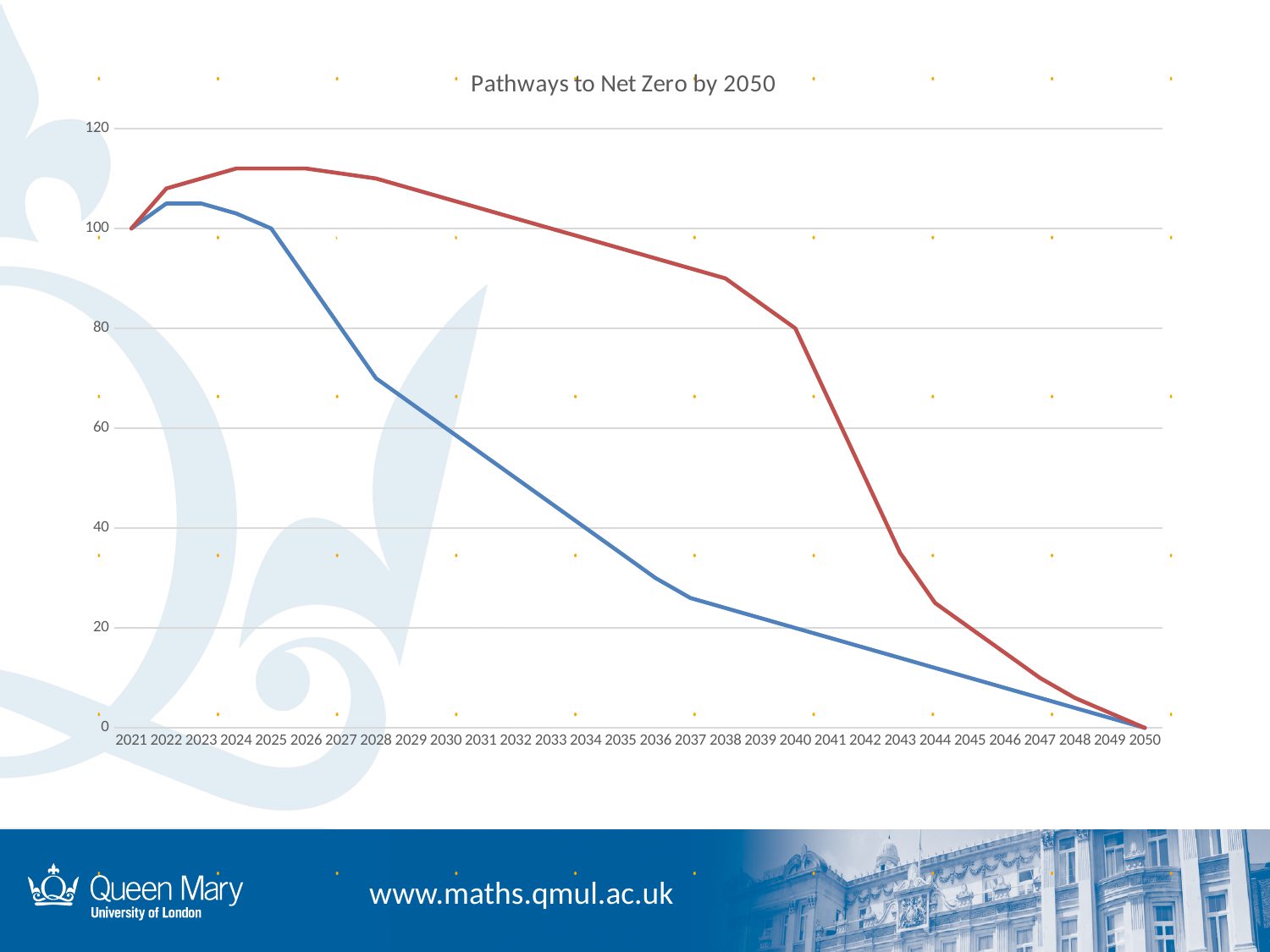
How many lines are plotted on the chart? 2 Do the values of the blue line rise or fall between 2030 and 2050? fall What is the title of the chart? Pathways to Net Zero by 2050 What value do both lines start at in 2021? 100 How many years are labelled along the x axis of the chart? 30 Is the value of the red line in 2025 greater or less than 100? greater What kind of chart is shown on the slide? line chart Is the value of the red line in 2035 greater or less than 80? greater Is the value of the blue line in 2045 greater or less than 20? less What value do both lines reach in 2050? 0 In 2038, which line has the higher value, the red line or the blue line? the red line